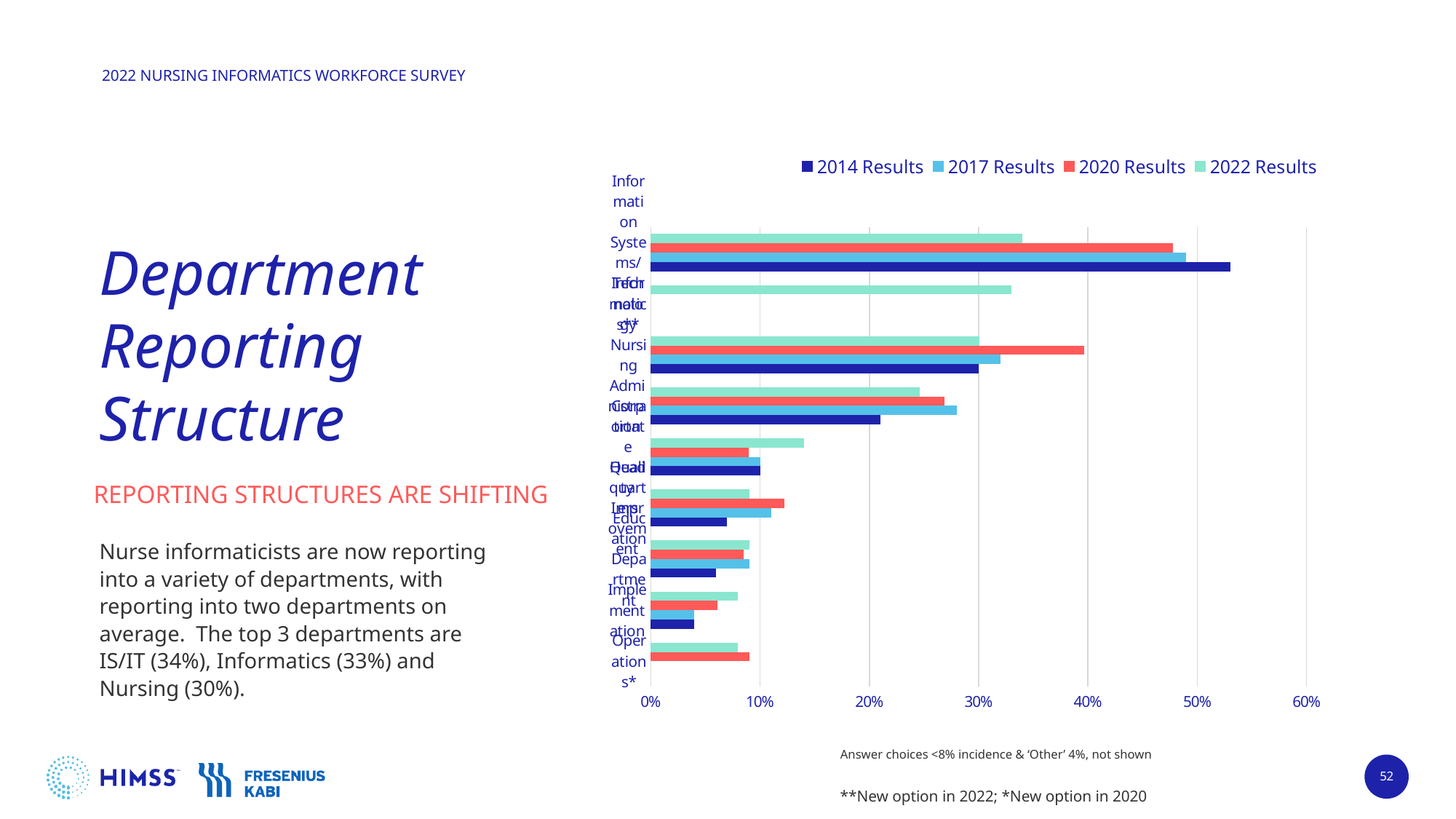
Which series has the lowest value for Information Systems/IT? 2022 Results Is the 2014 Results value for Information Systems/IT greater or less than 50%? greater For Information Systems/IT, which is larger: the 2014 Results value or the 2022 Results value? 2014 Results What is the 2022 Results value for Nursing? 30% What kind of chart is shown on the slide? bar chart How many series does the chart legend list? 4 Is the 2022 Results value for Information Systems/IT greater or less than 30%? greater Which series has the highest value for Information Systems/IT? 2014 Results What are the series names listed in the chart legend? 2014 Results, 2017 Results, 2020 Results, 2022 Results Is the 2020 Results value for Nursing greater or less than 30%? greater Which series has the highest value for Nursing? 2020 Results What is the highest value shown on the chart's horizontal axis? 60%